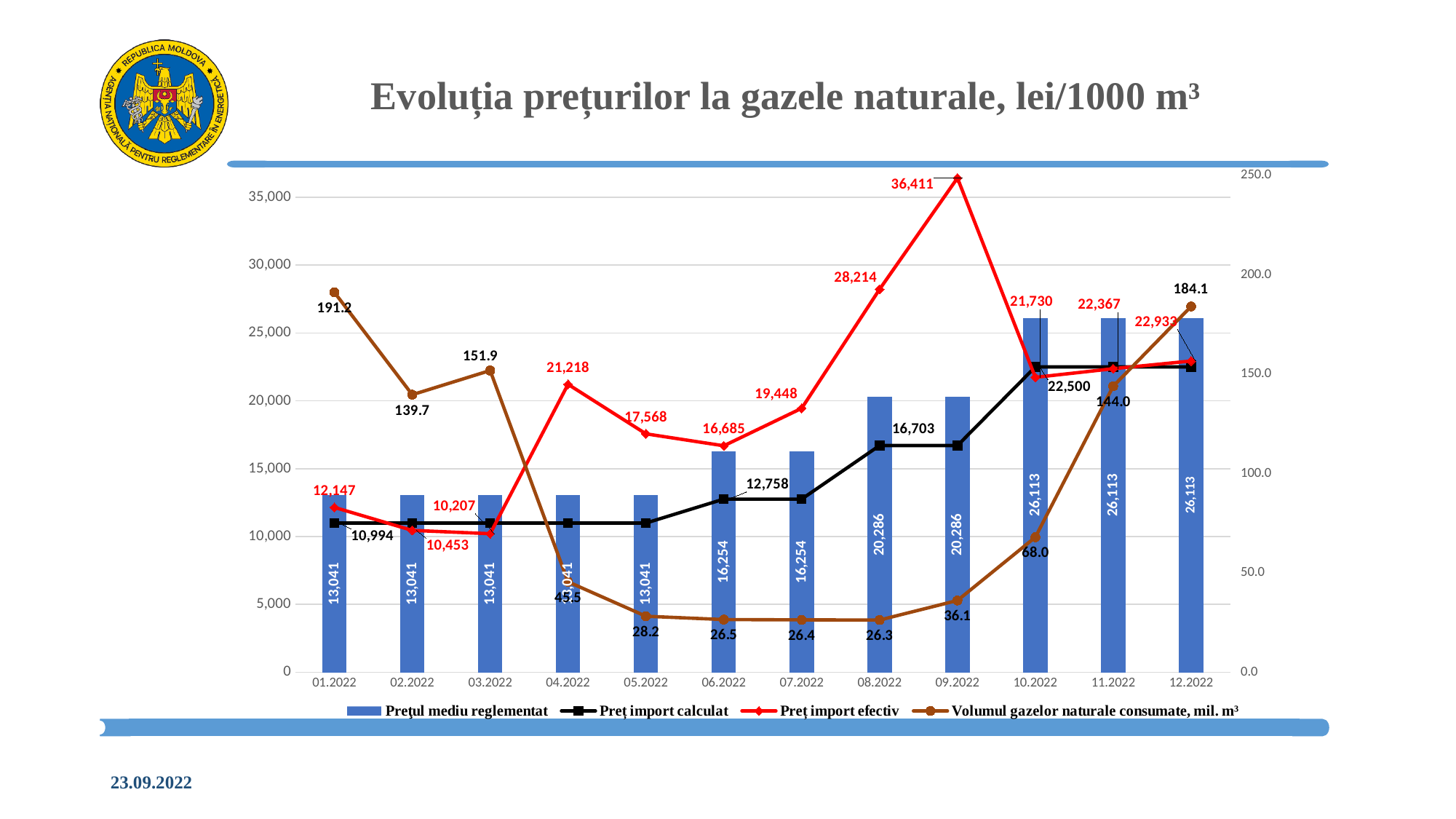
What is the value of Prețul mediu reglementat in 10.2022? 26,113 Which series is shown as blue bars? Prețul mediu reglementat In which month is Volumul gazelor naturale consumate highest? 01.2022 How many months are shown on the x axis? 12 What is the difference between Preț import efectiv in 09.2022 and in 08.2022? 8,197 What kind of chart is shown on the slide? A combined bar and line chart Does Prețul mediu reglementat rise or fall from 01.2022 to 12.2022? Rises How many series does the legend list? 4 What is the value of Volumul gazelor naturale consumate in 04.2022? 45.5 In 04.2022, which is larger: Preț import efectiv or Prețul mediu reglementat? Preț import efectiv In which month is Preț import efectiv highest? 09.2022 What is the value of Preț import efectiv in 09.2022? 36,411